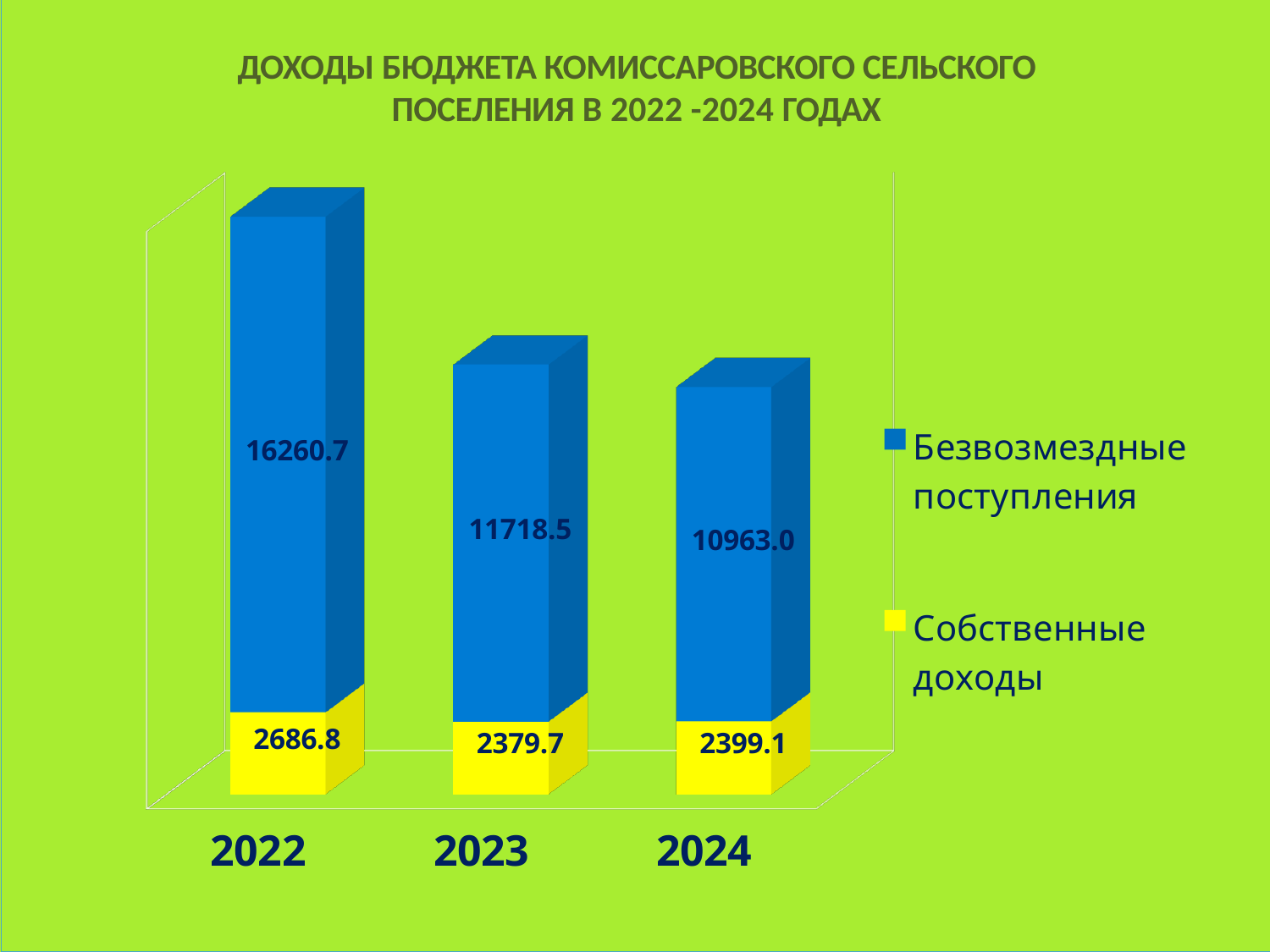
What is the value of Безвозмездные поступления for 2024? 10963.0 Which is larger: Безвозмездные поступления in 2023 or in 2024? 2023 Which year has the highest value for Безвозмездные поступления? 2022 What is the difference between Собственные доходы in 2024 and 2023? 19.4 What is the value of Безвозмездные поступления for 2022? 16260.7 What is the total of the stacked bar for 2024? 13362.1 Which year has the lowest value for Собственные доходы? 2023 What is the difference between Безвозмездные поступления in 2022 and 2023? 4542.2 What is the total of the stacked bar for 2022? 18947.5 What is the value of Собственные доходы for 2023? 2379.7 What kind of chart is shown on the slide? Stacked bar chart How many series does the legend list? 2